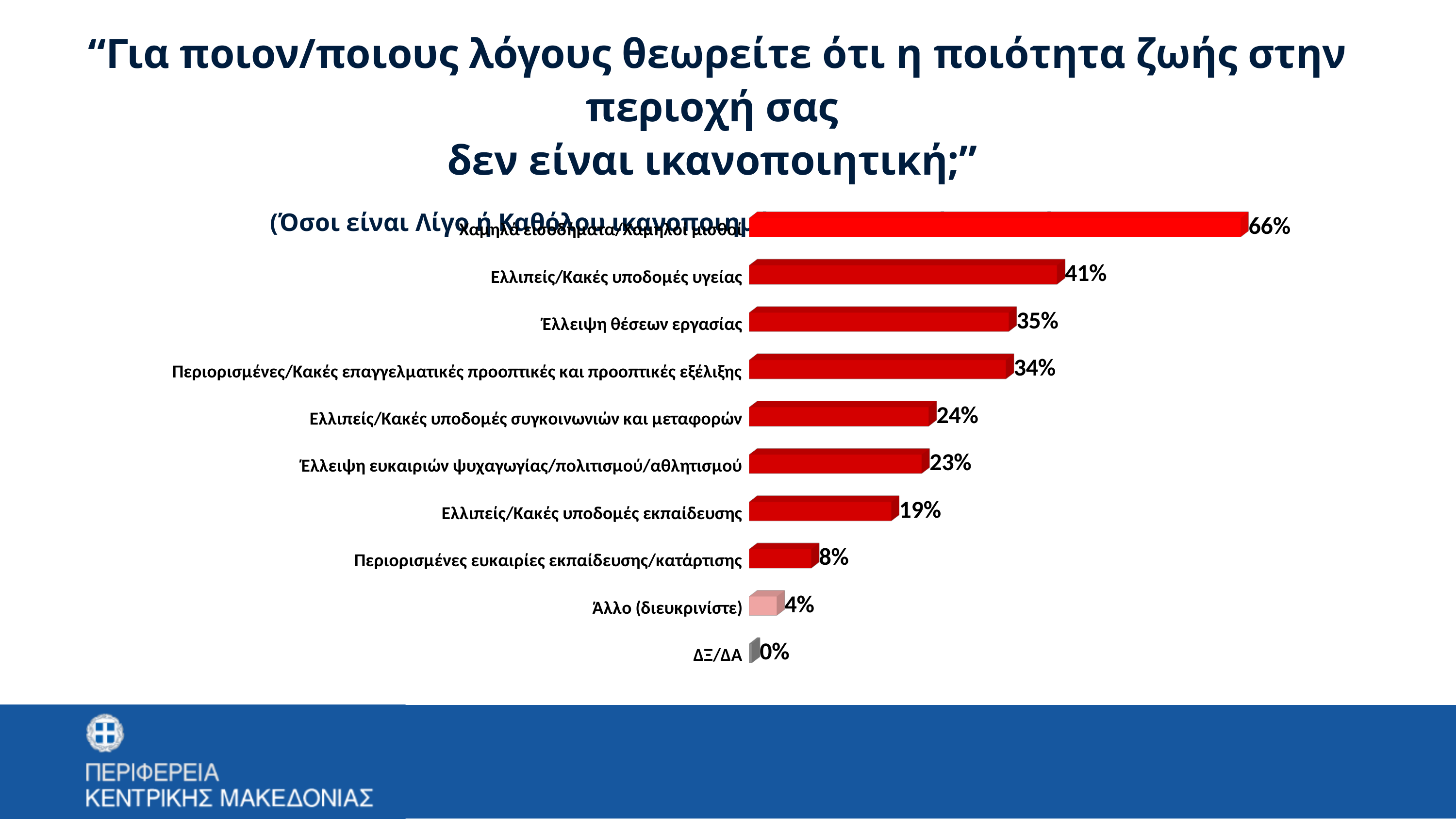
What is the value for Άλλο (διευκρινίστε)? 4% What is the value for Έλλειψη θέσεων εργασίας? 35% How many categories are shown in the chart? 10 What colour is the bar for ΔΞ/ΔΑ? Grey What is the value for Ελλιπείς/Κακές υποδομές συγκοινωνιών και μεταφορών? 24% What is the value of the longest bar in the chart? 66% What is the difference between Ελλιπείς/Κακές υποδομές υγείας and Ελλιπείς/Κακές υποδομές εκπαίδευσης? 22 percentage points Which is larger: Έλλειψη θέσεων εργασίας or Περιορισμένες/Κακές επαγγελματικές προοπτικές και προοπτικές εξέλιξης? Έλλειψη θέσεων εργασίας What is the value for Ελλιπείς/Κακές υποδομές υγείας? 41% What kind of chart is shown on the slide? Bar chart Which category has the lowest value? ΔΞ/ΔΑ What is the value for Περιορισμένες ευκαιρίες εκπαίδευσης/κατάρτισης? 8%